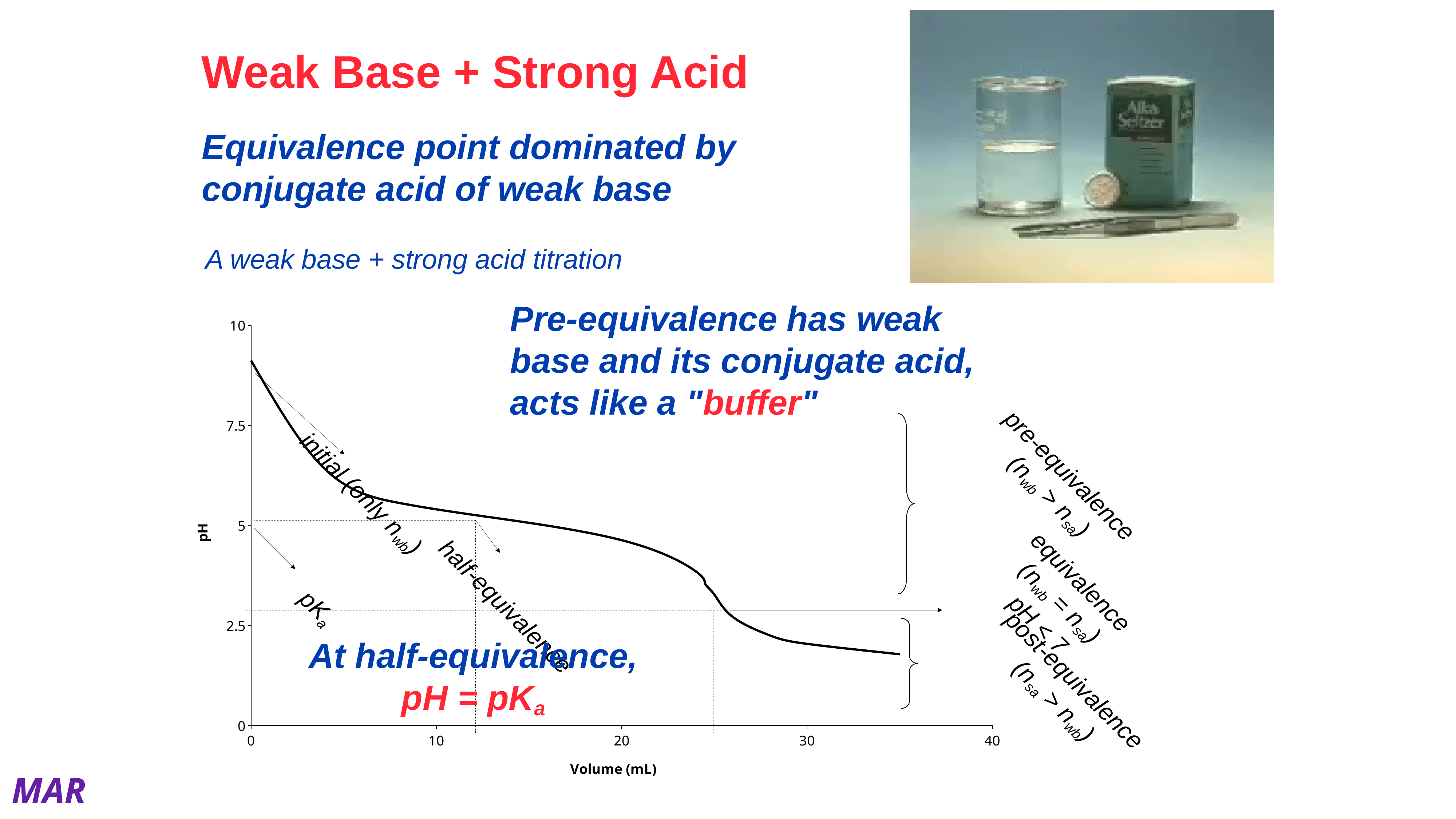
Which is larger, the pH at 5 mL or the pH at 30 mL? pH at 5 mL What kind of chart is shown on the slide? line chart Is the pH at 20 mL greater or less than 7.5? less Is the pH at 35 mL greater or less than 2.5? less Does the pH rise or fall as the volume increases along the x axis? fall Is the pH at 0 mL greater or less than 7.5? greater What is the highest value shown on the y axis of the chart? 10 What is the label of the x axis of the chart? Volume (mL) How many curves are plotted on the chart? 1 What is the label of the y axis of the chart? pH